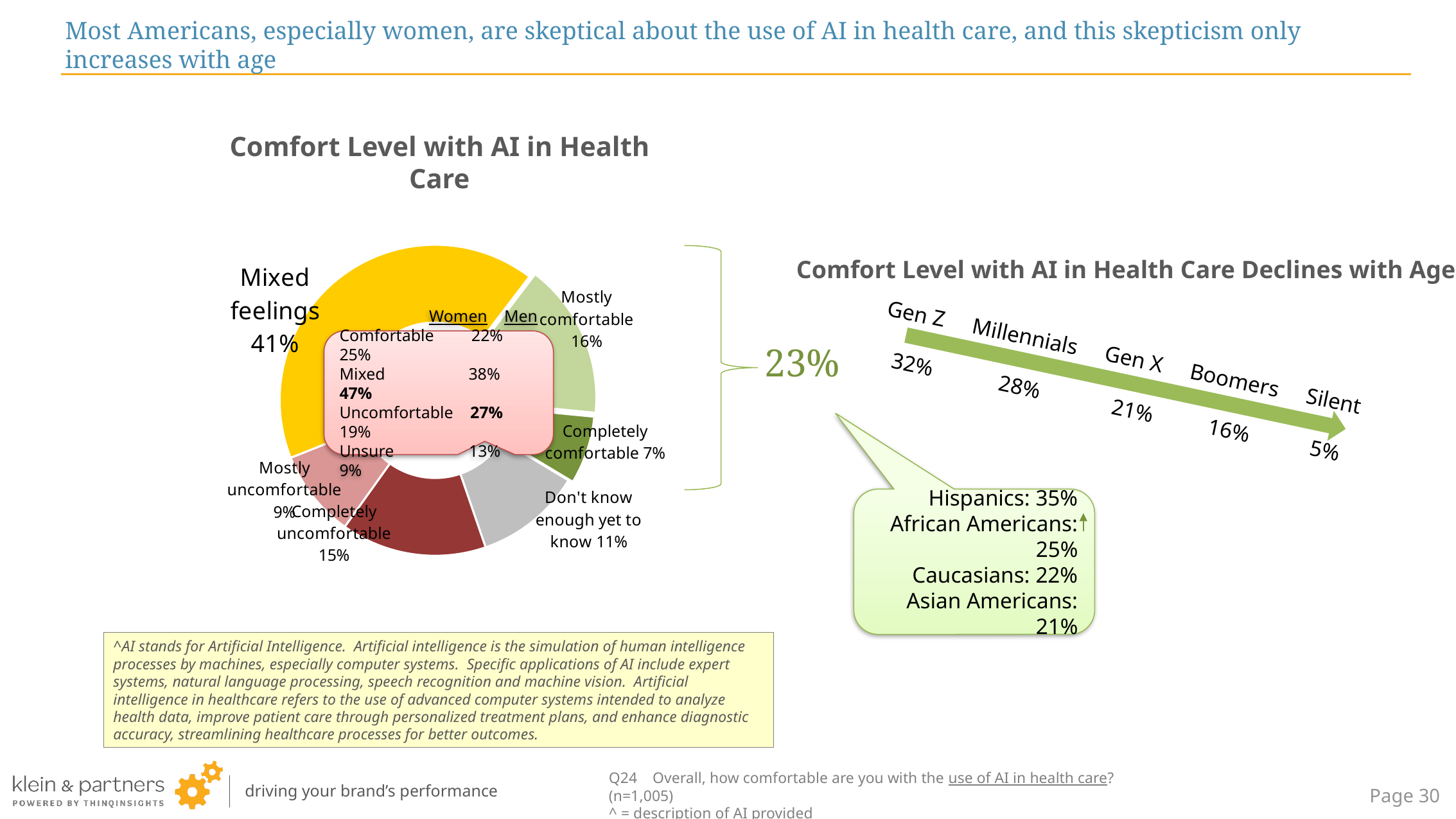
In the Comfort Level with AI in Health Care chart, what percentage are completely comfortable? 7% In the Comfort Level with AI in Health Care chart, which is larger: completely uncomfortable or don't know enough yet to know? Completely uncomfortable In the Comfort Level with AI in Health Care chart, what percentage are mostly uncomfortable? 9% In the Comfort Level with AI in Health Care chart, how many percentage points larger is the mostly comfortable share than the completely comfortable share? 9 percentage points In the Comfort Level with AI in Health Care chart, what percentage have mixed feelings? 41% In the Comfort Level with AI in Health Care chart, which category has the smallest share? Completely comfortable How many categories are shown in the Comfort Level with AI in Health Care chart? 6 What kind of chart is the Comfort Level with AI in Health Care chart? Pie (donut) chart In the Comfort Level with AI in Health Care chart, what percentage are completely uncomfortable? 15% In the Comfort Level with AI in Health Care chart, what percentage are mostly comfortable? 16% In the Comfort Level with AI in Health Care chart, what percentage say they don't know enough yet to know? 11% In the Comfort Level with AI in Health Care chart, which category has the largest share? Mixed feelings